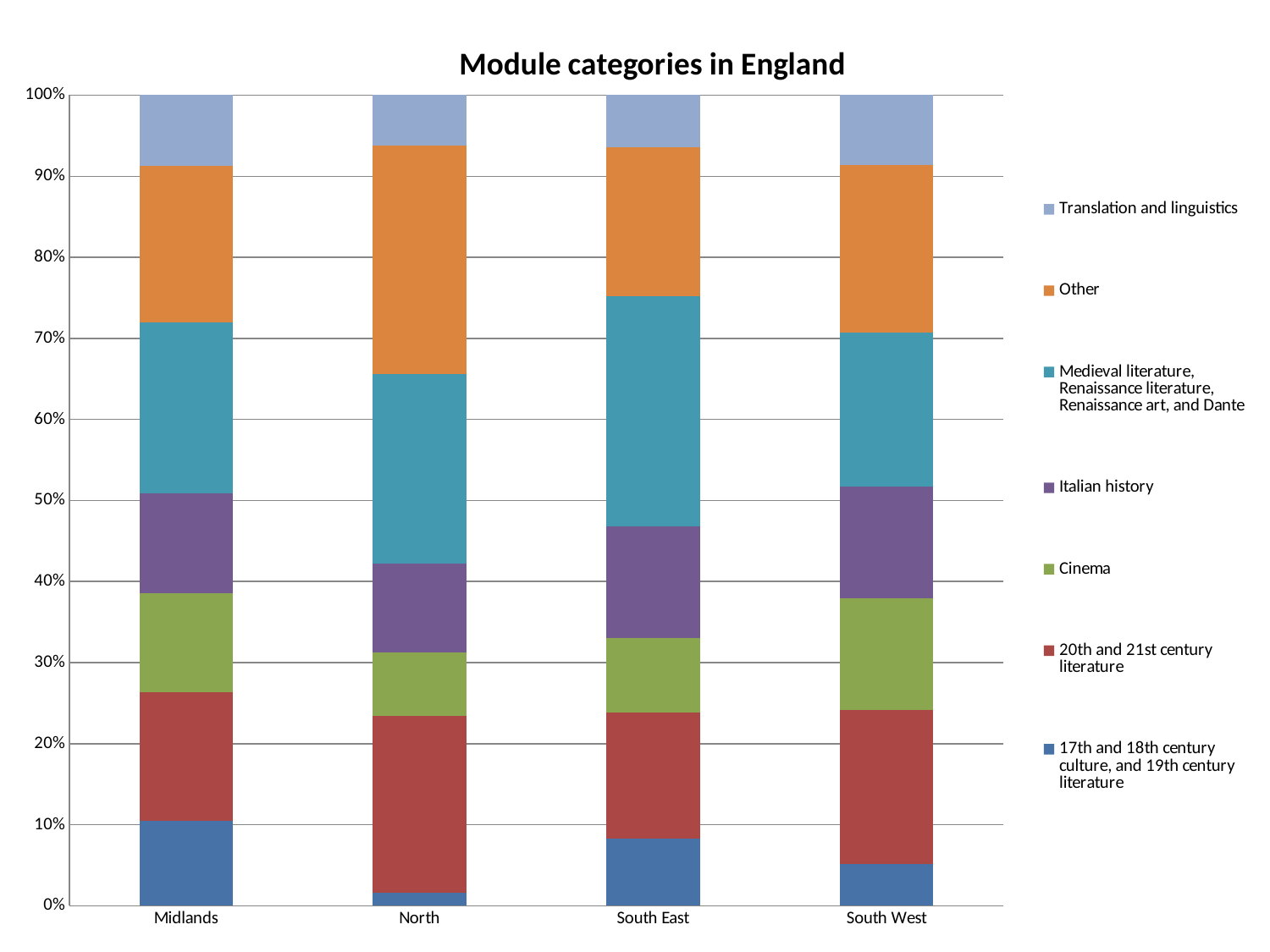
Is the share of 17th and 18th century culture, and 19th century literature for North greater or less than 10%? less How many series does the legend list? 7 What kind of chart is shown on the slide? Stacked bar chart Which region has the largest share of Other modules? North How many regions are shown along the x axis? 4 What is the title of the chart? Module categories in England Is the share of Medieval literature, Renaissance literature, Renaissance art, and Dante larger for South East or for North? South East Which series is plotted at the top of each stacked bar? Translation and linguistics Is the share of 17th and 18th century culture, and 19th century literature for South West greater or less than 10%? less Which region has the largest share of 17th and 18th century culture, and 19th century literature? Midlands Which region has the smallest share of 17th and 18th century culture, and 19th century literature? North Is the Cinema share larger for South West or for North? South West